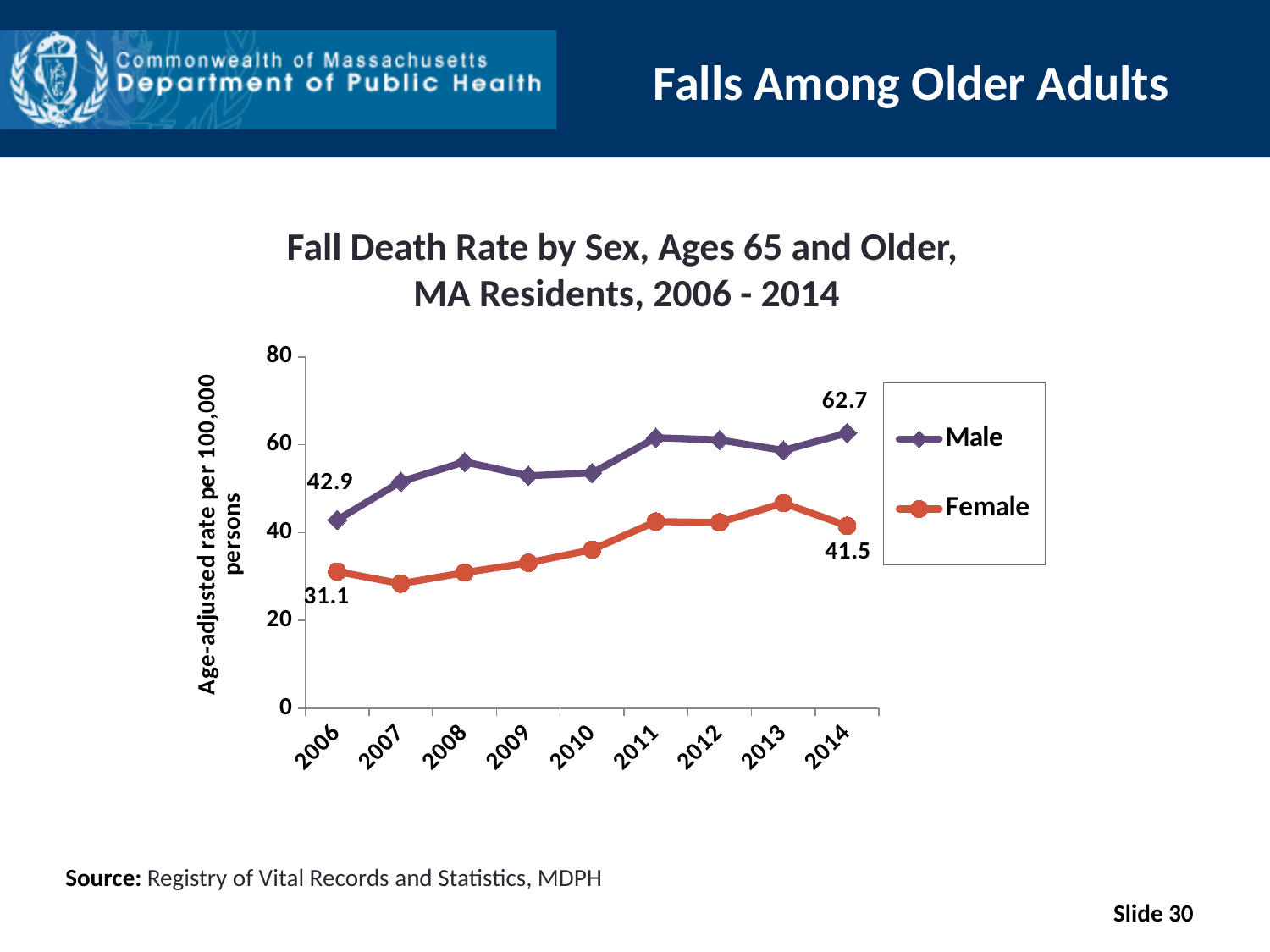
What is the Male fall death rate in 2006? 42.9 What is the Male fall death rate in 2014? 62.7 What is the Female fall death rate in 2014? 41.5 Is the Female value for 2013 greater or less than 40? greater What is the Female fall death rate in 2006? 31.1 Is the Male value for 2011 greater or less than 60? greater Which series has the higher fall death rate in 2010, Male or Female? Male By how much did the Male fall death rate change from 2006 to 2014? 19.8 What kind of chart is shown on the slide? Line chart What is the difference between the Male and Female fall death rates in 2014? 21.2 How many series does the legend list? 2 How many years are shown on the x axis? 9